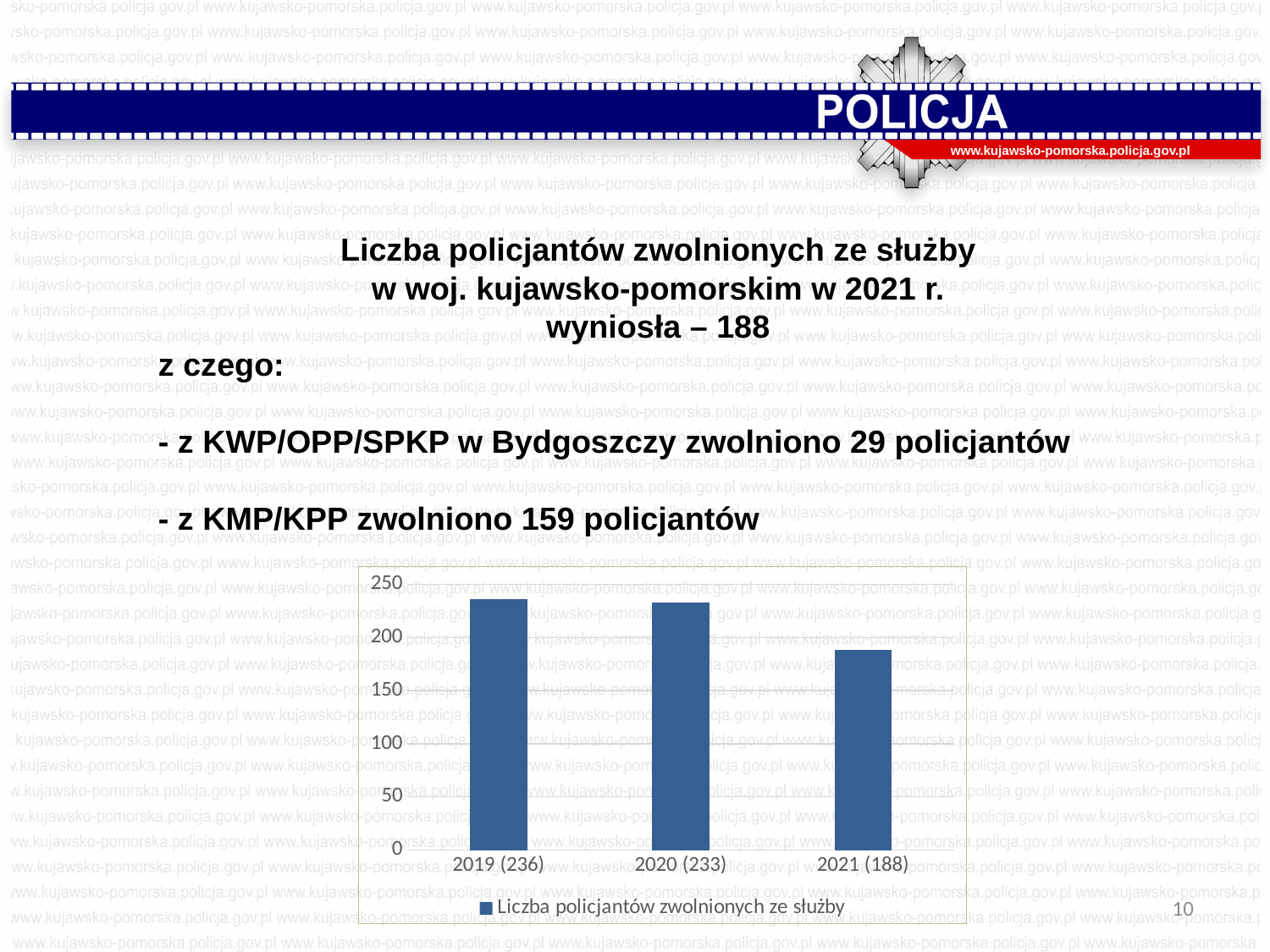
What is the value for 2020 in the chart? 233 How many series does the chart legend list? 1 Is the value for 2021 greater or less than 200? less What is the difference between the values for 2019 and 2021? 48 Which is larger, the value for 2020 or the value for 2021? 2020 How many years are shown on the x axis of the chart? 3 What is the value for 2021 in the chart? 188 Which year has the highest value in the chart? 2019 Do the values rise or fall from 2019 to 2021? fall Which year has the lowest value in the chart? 2021 What is the value for 2019 in the chart? 236 What kind of chart is shown on the slide? bar chart